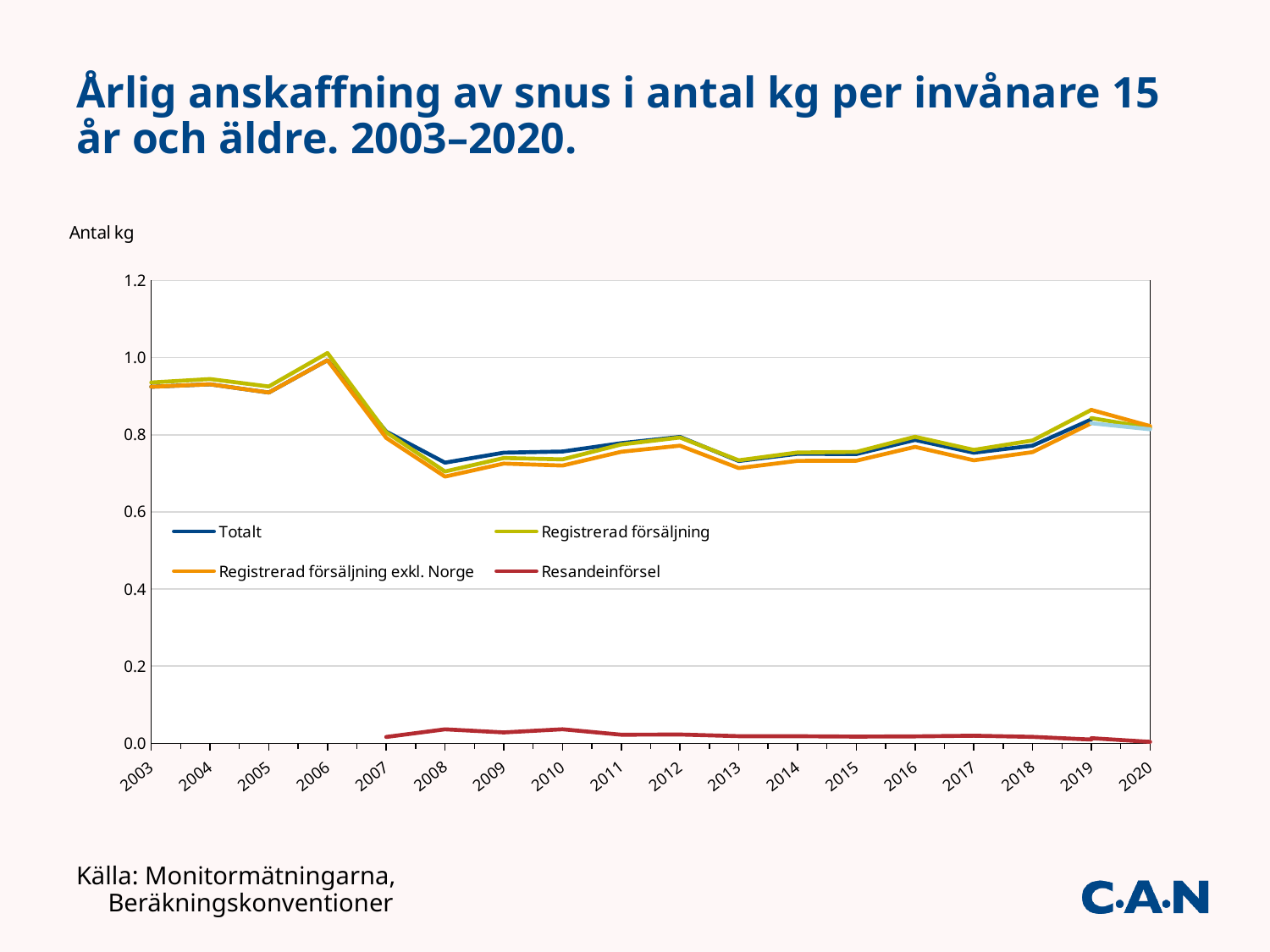
What kind of chart is shown on the slide? line chart Does the Totalt series rise or fall between 2006 and 2008? fall In which year does the Totalt series reach its highest value? 2006 Is the value for Resandeinförsel in 2010 greater or less than 0.2? less Is the value for Totalt in 2003 greater or less than 0.8? greater In 2012, which series has the larger value: Totalt or Resandeinförsel? Totalt How many years are shown along the x axis? 18 What label is shown on the y axis of the chart? Antal kg How many series does the legend list? 4 Which is larger for the Totalt series: the value in 2006 or the value in 2008? 2006 Is the value for Totalt in 2008 greater or less than 0.8? less In which year does the Resandeinförsel series first appear on the chart? 2007